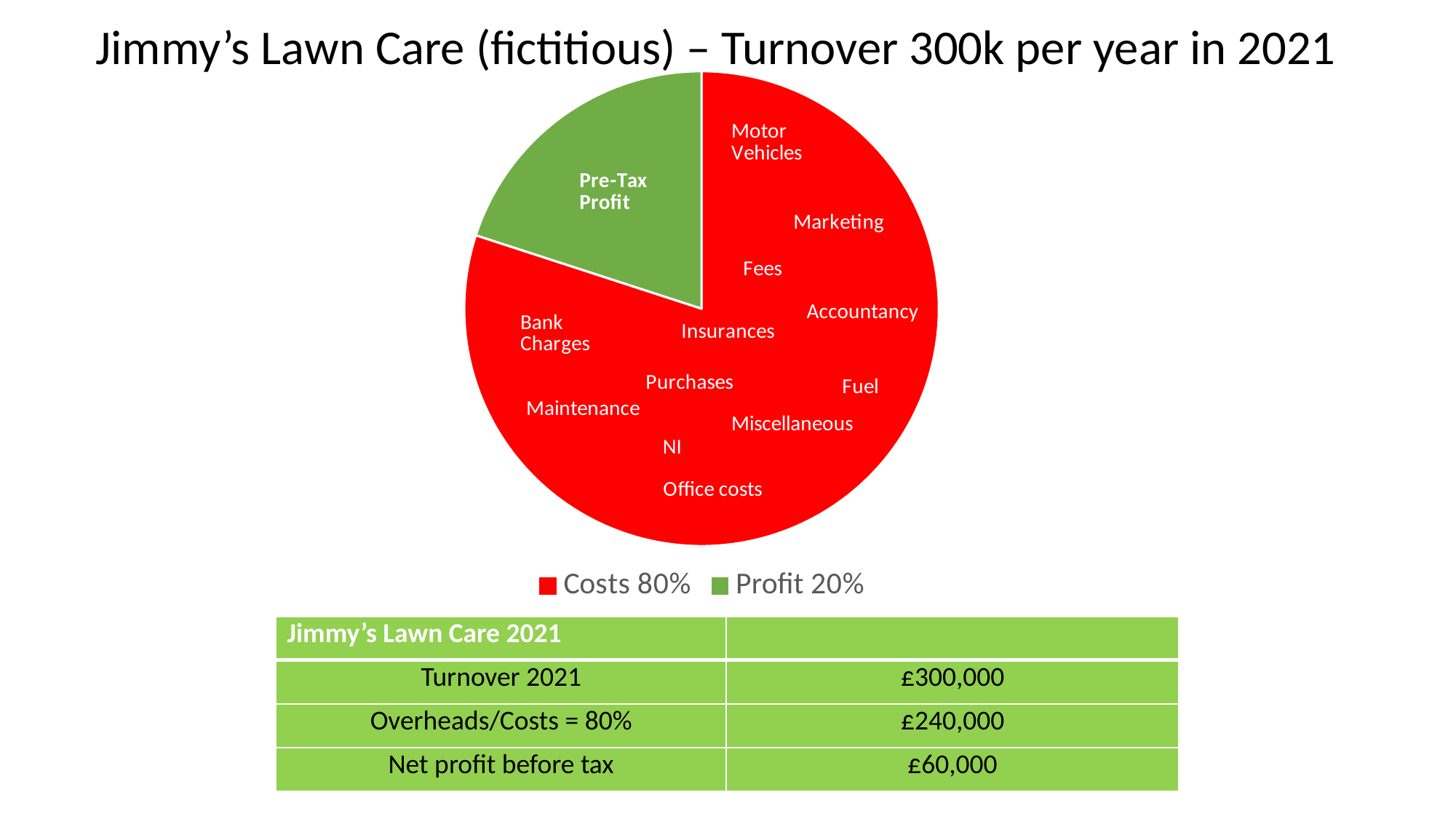
What is the difference in percentage points between the Costs share and the Profit share in the pie chart? 60 percentage points What kind of chart is shown on the slide? pie chart Is the Profit share in the pie chart greater or less than 50%? less How many slices does the pie chart have? 2 What colour is the Profit slice in the pie chart? green What label is printed inside the green slice of the pie chart? Pre-Tax Profit Which slice of the pie chart is the smallest? Profit How many entries does the legend of the pie chart list? 2 What share of the pie does the Profit slice represent? 20% Which is larger in the pie chart, the Costs slice or the Profit slice? Costs Which slice of the pie chart is the largest? Costs What share of the pie does the Costs slice represent? 80%